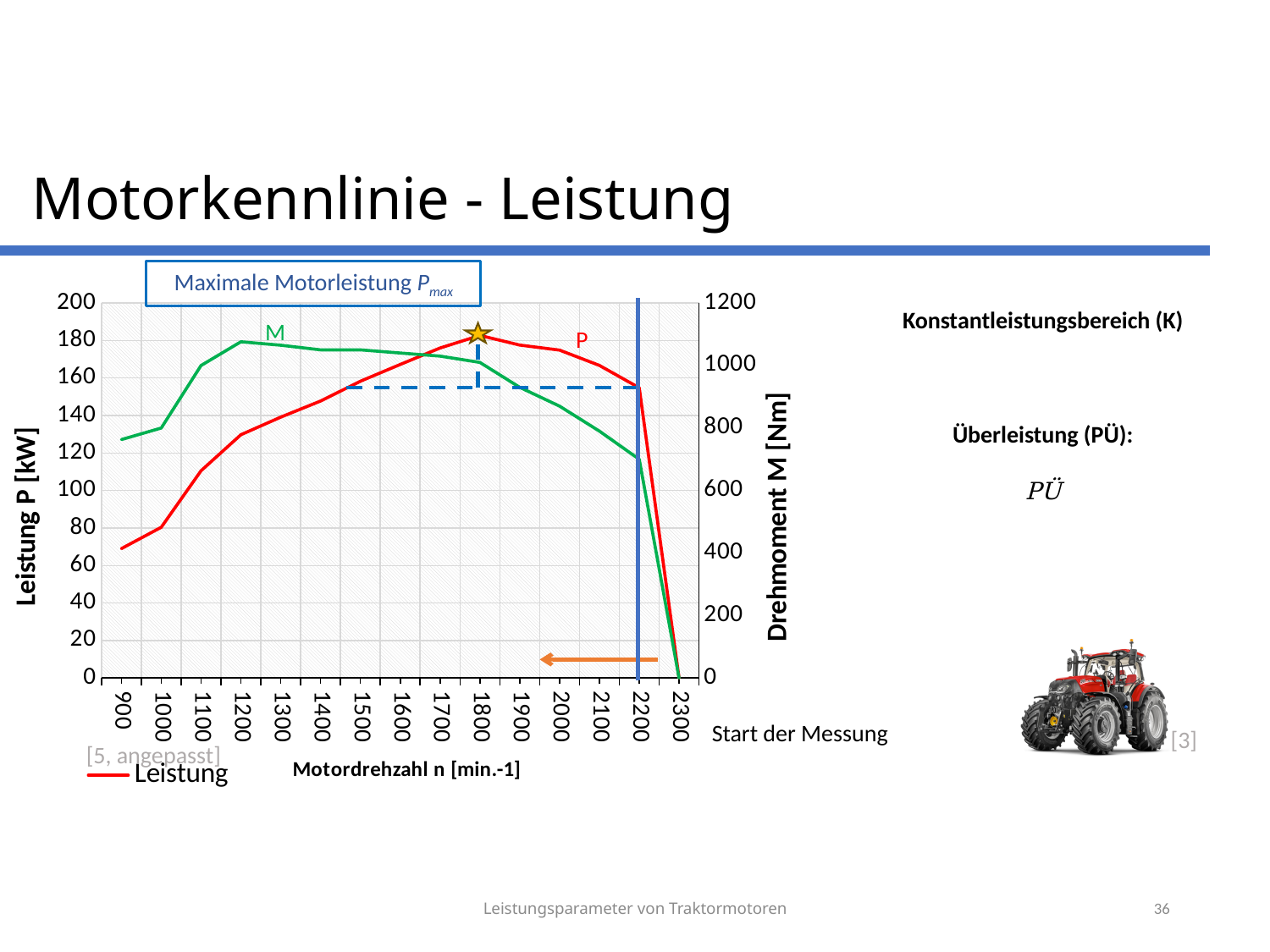
Is the value of the P curve at 1800 greater or less than 160 kW? greater Is the value of the M curve at 2200 greater or less than 800 Nm? less What kind of chart is shown on the slide? line chart How many tick labels are shown on the x axis of the chart? 15 Which is larger: the M curve value at 1200 or at 2200? 1200 Is the value of the P curve at 900 greater or less than 80 kW? less At which engine speed does the P curve reach its maximum (marked with a star)? 1800 What is the label of the x axis of the chart? Motordrehzahl n [min.-1] How many entries does the chart legend list? 1 Does the P curve rise or fall between 900 and 1800 on the x axis? rise What colour is the line labelled P in the chart? red